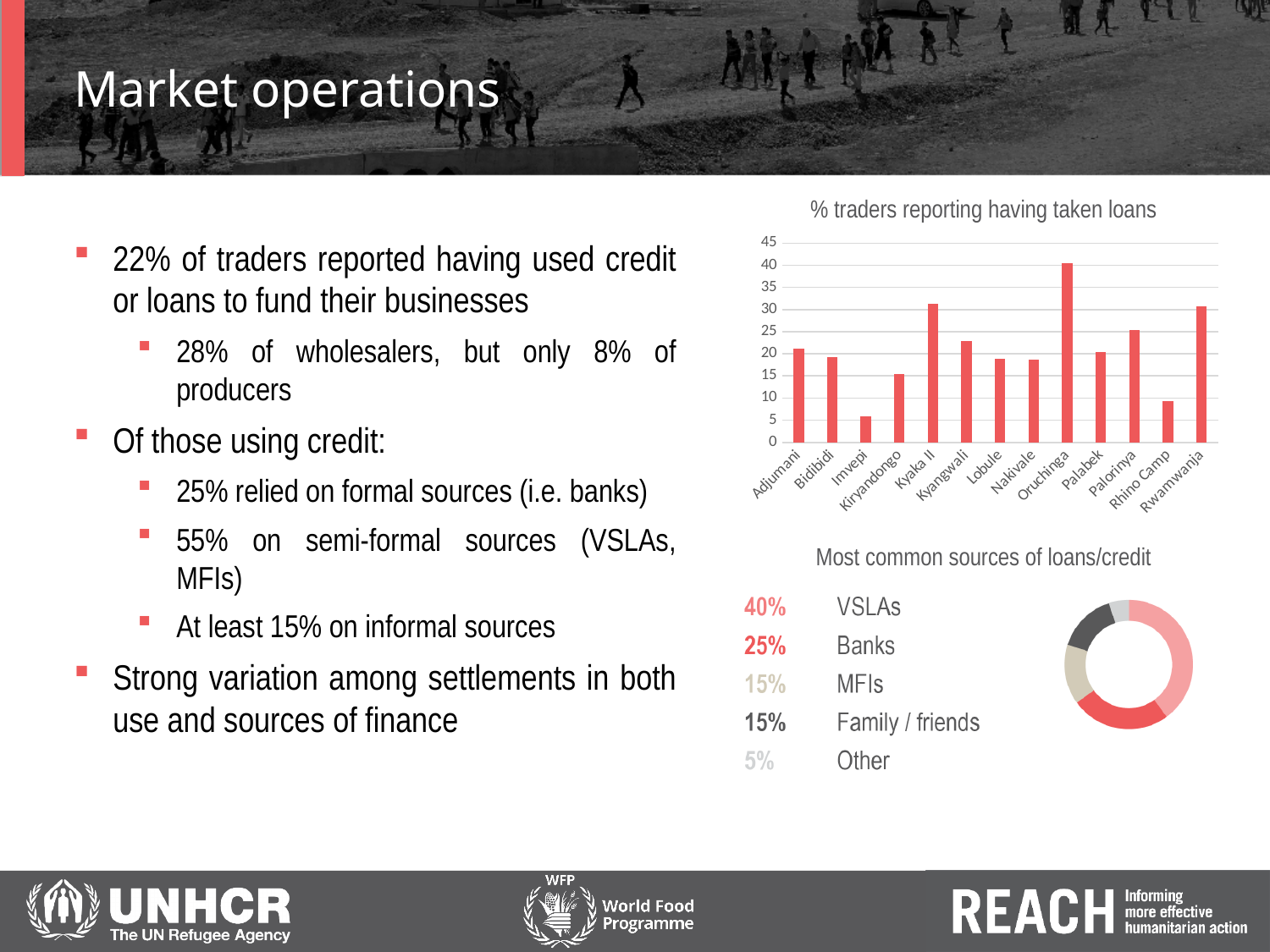
In the chart '% traders reporting having taken loans', which settlement has the lowest value? Imvepi What kind of chart is '% traders reporting having taken loans'? Bar chart In the chart 'Most common sources of loans/credit', what share is attributed to VSLAs? 40% In the chart '% traders reporting having taken loans', which has the larger value, Kyaka II or Kiryandongo? Kyaka II In the chart 'Most common sources of loans/credit', how many percentage points larger is the VSLAs share than the Banks share? 15% How many sources are listed in the chart 'Most common sources of loans/credit'? 5 In the chart 'Most common sources of loans/credit', what share is attributed to Banks? 25% In the chart '% traders reporting having taken loans', which settlement has the highest value? Oruchinga How many settlements are shown in the chart '% traders reporting having taken loans'? 13 In the chart '% traders reporting having taken loans', is the value for Oruchinga greater or less than 35? greater In the chart '% traders reporting having taken loans', is the value for Kyaka II greater or less than 30? greater